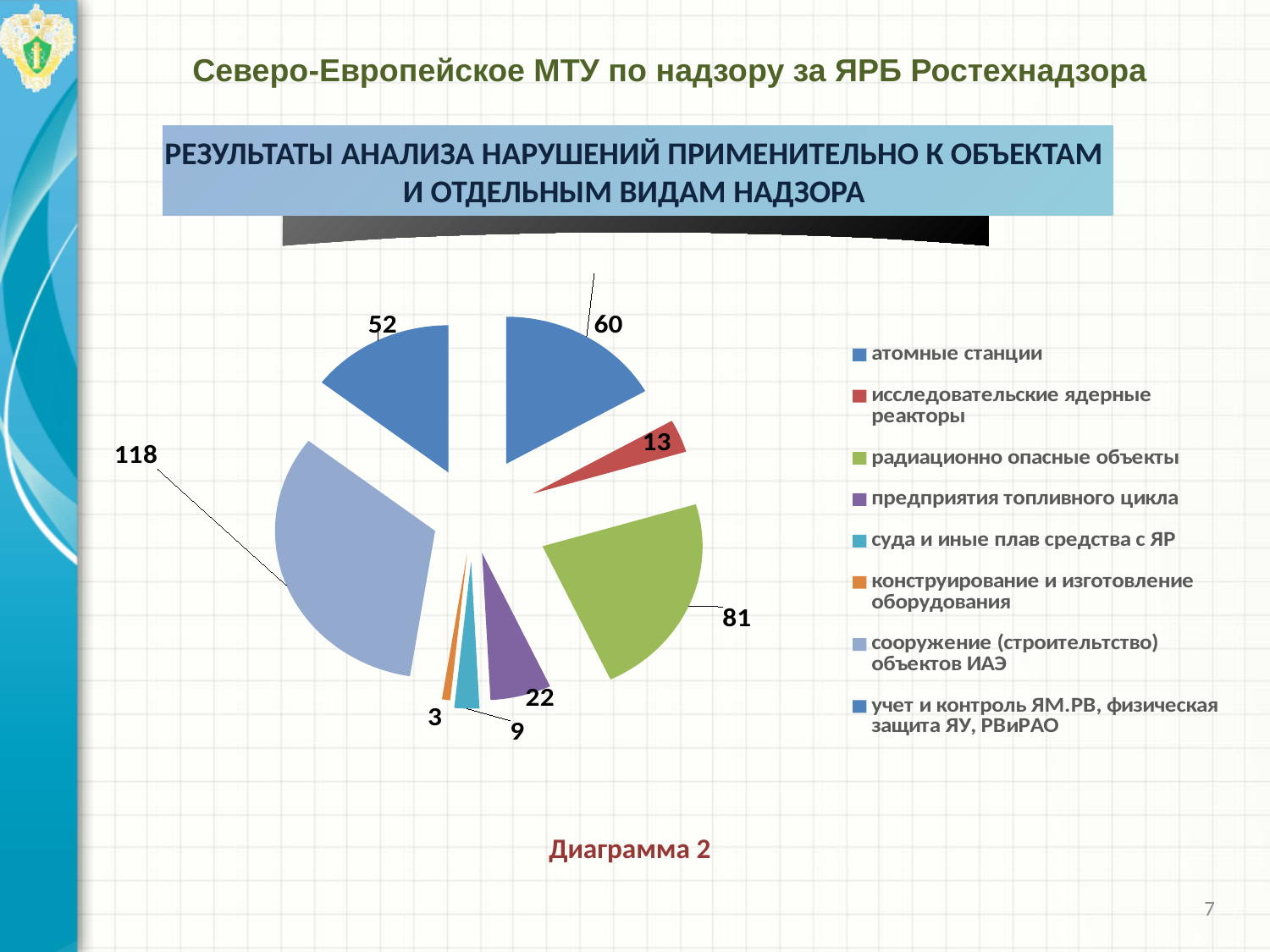
What is the value for 'сооружение (строительство) объектов ИАЭ' in the pie chart? 118 How many entries does the legend of the pie chart list? 8 What is the difference between the values for 'сооружение (строительство) объектов ИАЭ' and 'радиационно опасные объекты'? 37 What is the value for 'атомные станции' in the pie chart? 60 What kind of chart is shown on the slide? pie chart What is the value for 'суда и иные плав средства с ЯР' in the pie chart? 9 Which is larger in the pie chart: 'атомные станции' or 'учет и контроль ЯМ.РВ, физическая защита ЯУ, РВиРАО'? атомные станции What is the value for 'радиационно опасные объекты' in the pie chart? 81 What is the caption printed below the pie chart? Диаграмма 2 Which category has the largest slice in the pie chart? сооружение (строительство) объектов ИАЭ How many slices does the pie chart have? 8 Which category has the smallest slice in the pie chart? конструирование и изготовление оборудования